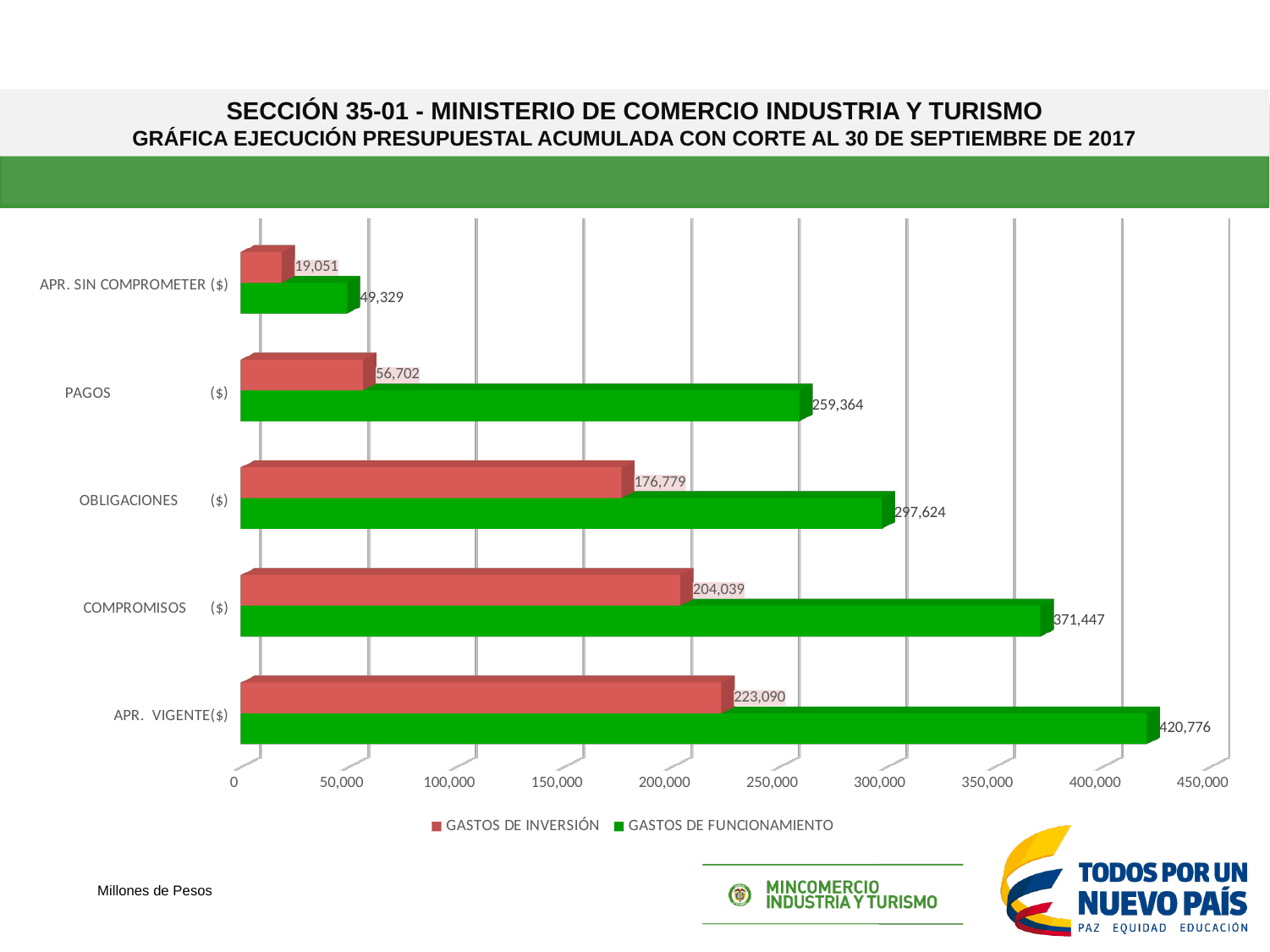
What is the value of GASTOS DE FUNCIONAMIENTO for APR. VIGENTE? 420,776 What kind of chart is shown on the slide? Bar chart How many series does the legend list? 2 What is the difference between GASTOS DE FUNCIONAMIENTO and GASTOS DE INVERSIÓN for COMPROMISOS? 167,408 Which category has the highest value for GASTOS DE FUNCIONAMIENTO? APR. VIGENTE Which category has the lowest value for GASTOS DE INVERSIÓN? APR. SIN COMPROMETER What is the value of GASTOS DE INVERSIÓN for OBLIGACIONES? 176,779 How many categories are shown on the chart? 5 Which series is shown in green in the legend? GASTOS DE FUNCIONAMIENTO What is the value of GASTOS DE FUNCIONAMIENTO for PAGOS? 259,364 What is the value of GASTOS DE INVERSIÓN for APR. SIN COMPROMETER? 19,051 Which is larger for PAGOS: GASTOS DE INVERSIÓN or GASTOS DE FUNCIONAMIENTO? GASTOS DE FUNCIONAMIENTO